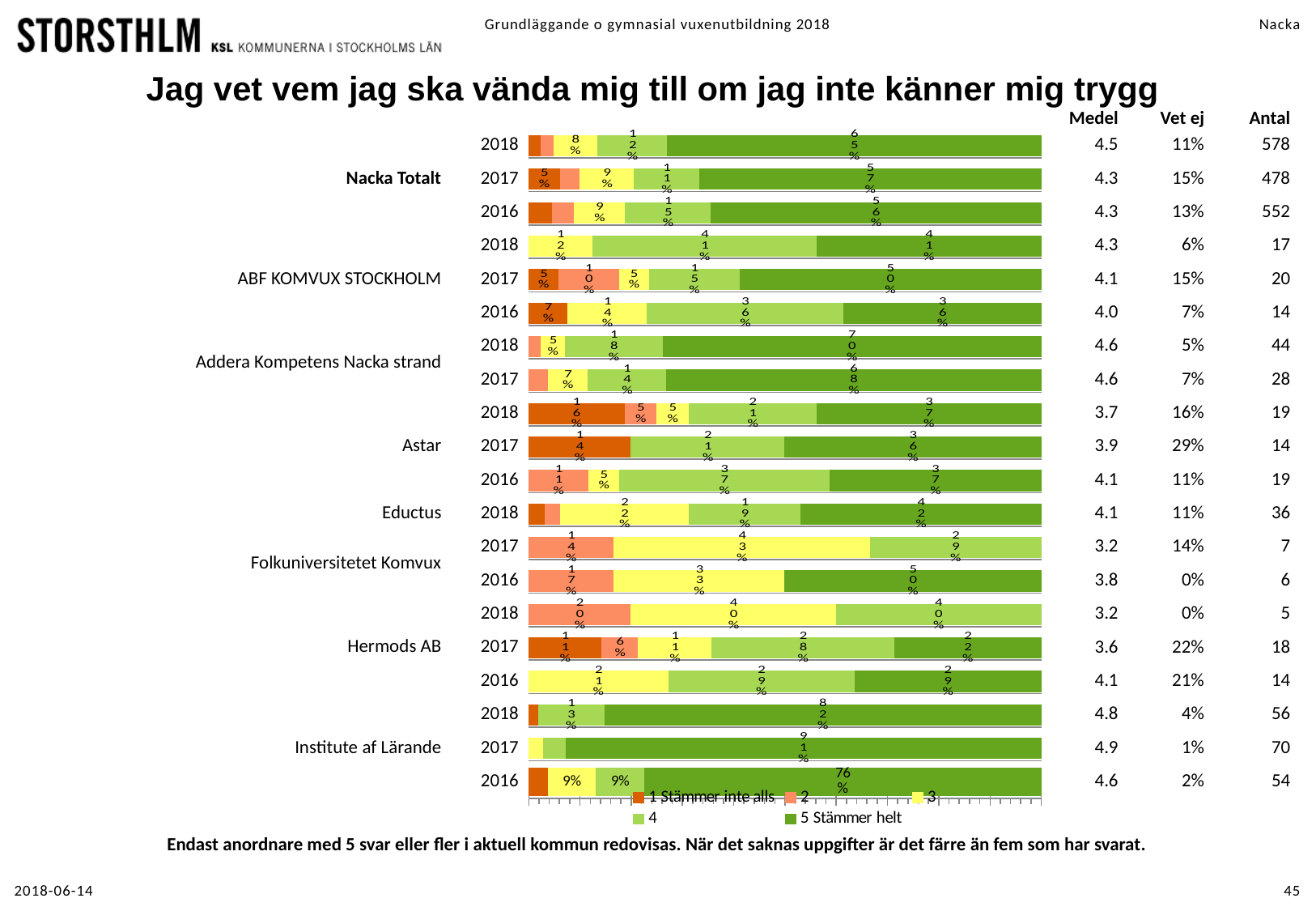
What share of Addera Kompetens Nacka strand respondents in 2018 answered '5 Stämmer helt'? 70% For Institute af Lärande, which year has the larger share of '5 Stämmer helt' answers, 2017 or 2016? 2017 What is the title of the chart? Jag vet vem jag ska vända mig till om jag inte känner mig trygg By how many percentage points does the '5 Stämmer helt' share for Institute af Lärande in 2017 exceed that in 2016? 15 How many series does the chart legend list? 5 What share of Nacka Totalt respondents in 2018 answered '3'? 8% What kind of chart is shown on the slide? bar chart What share of Institute af Lärande respondents in 2017 answered '5 Stämmer helt'? 91% What share of Nacka Totalt respondents in 2018 answered '5 Stämmer helt'? 65% What share of Institute af Lärande respondents in 2016 answered '5 Stämmer helt'? 76% What is the legend label for the dark green series? 5 Stämmer helt What share of Hermods AB respondents in 2018 answered '2'? 20%